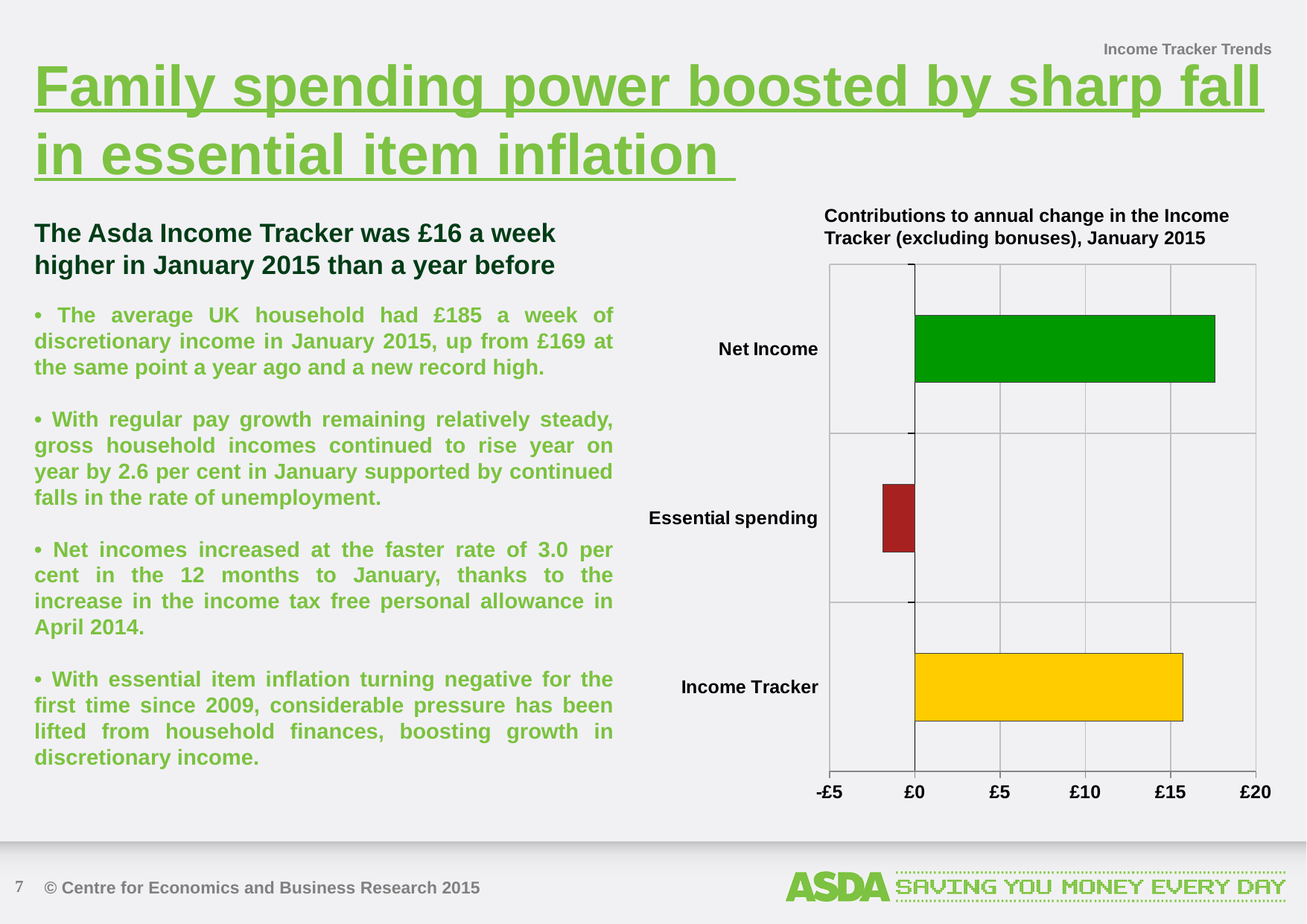
Is the value for Net Income greater or less than £15? greater Which category has the highest value in the chart? Net Income Is the value for Essential spending greater or less than £0? less Is the value for Net Income greater or less than £20? less How many categories are plotted in the chart? 3 Which category is the only one with a negative value? Essential spending Which category has the lowest value in the chart? Essential spending What kind of chart is shown on the slide? bar chart Which is larger, the value for Net Income or the value for Income Tracker? Net Income What is the title of the chart? Contributions to annual change in the Income Tracker (excluding bonuses), January 2015